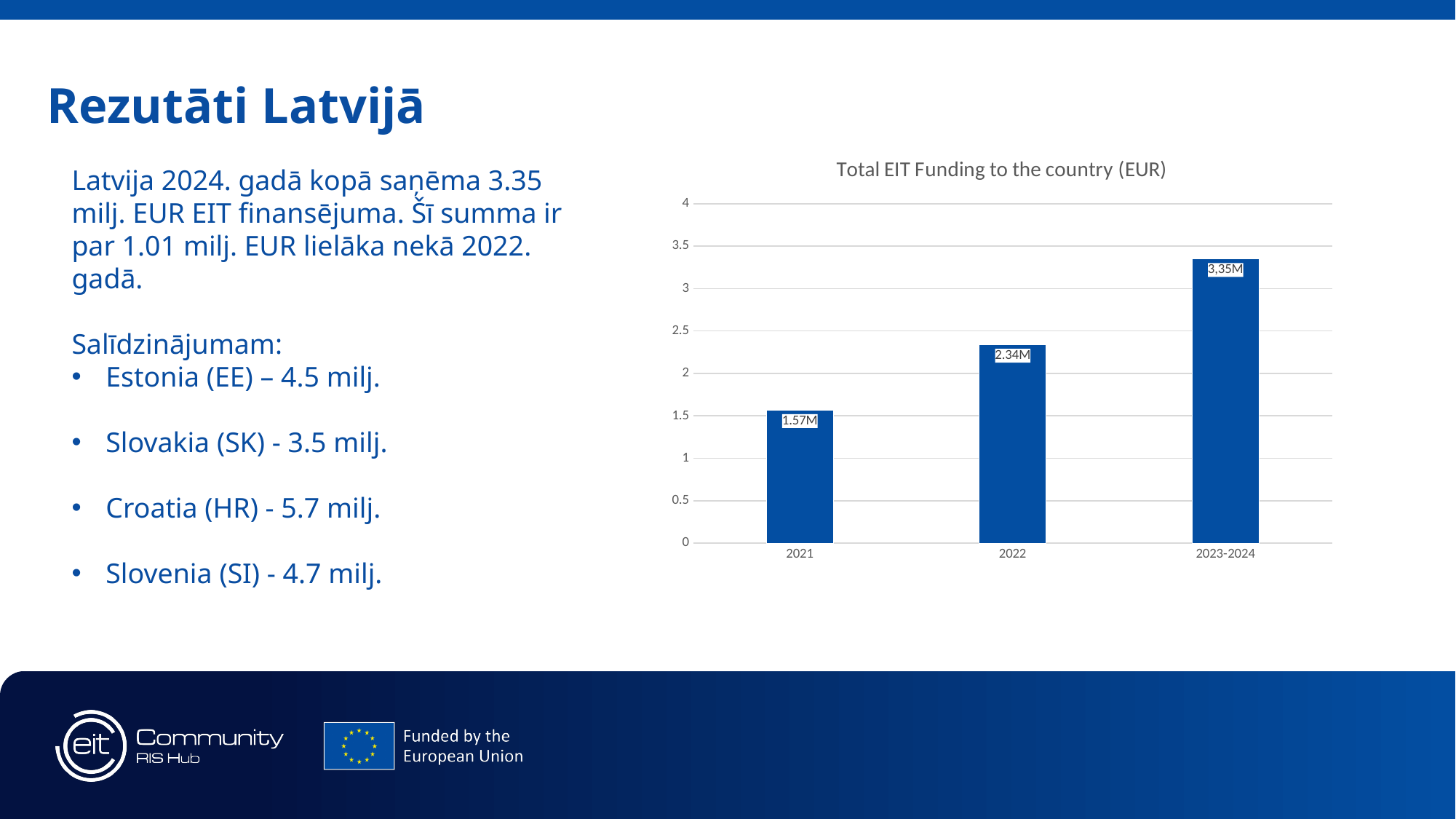
Do the values rise or fall from 2021 to 2023-2024? rise Which period has the highest total EIT funding? 2023-2024 Which is larger, the value for 2022 or the value for 2021? 2022 Is the value for 2021 greater or less than 2? less Is the value for 2022 greater or less than 2? greater What kind of chart is shown on the slide? bar chart What is the value for 2022 in the chart? 2.34M How many bars are shown in the chart? 3 What is the value for 2021 in the chart? 1.57M What is the value for 2023-2024 in the chart? 3,35M What is the title of the chart? Total EIT Funding to the country (EUR) Which period has the lowest total EIT funding? 2021